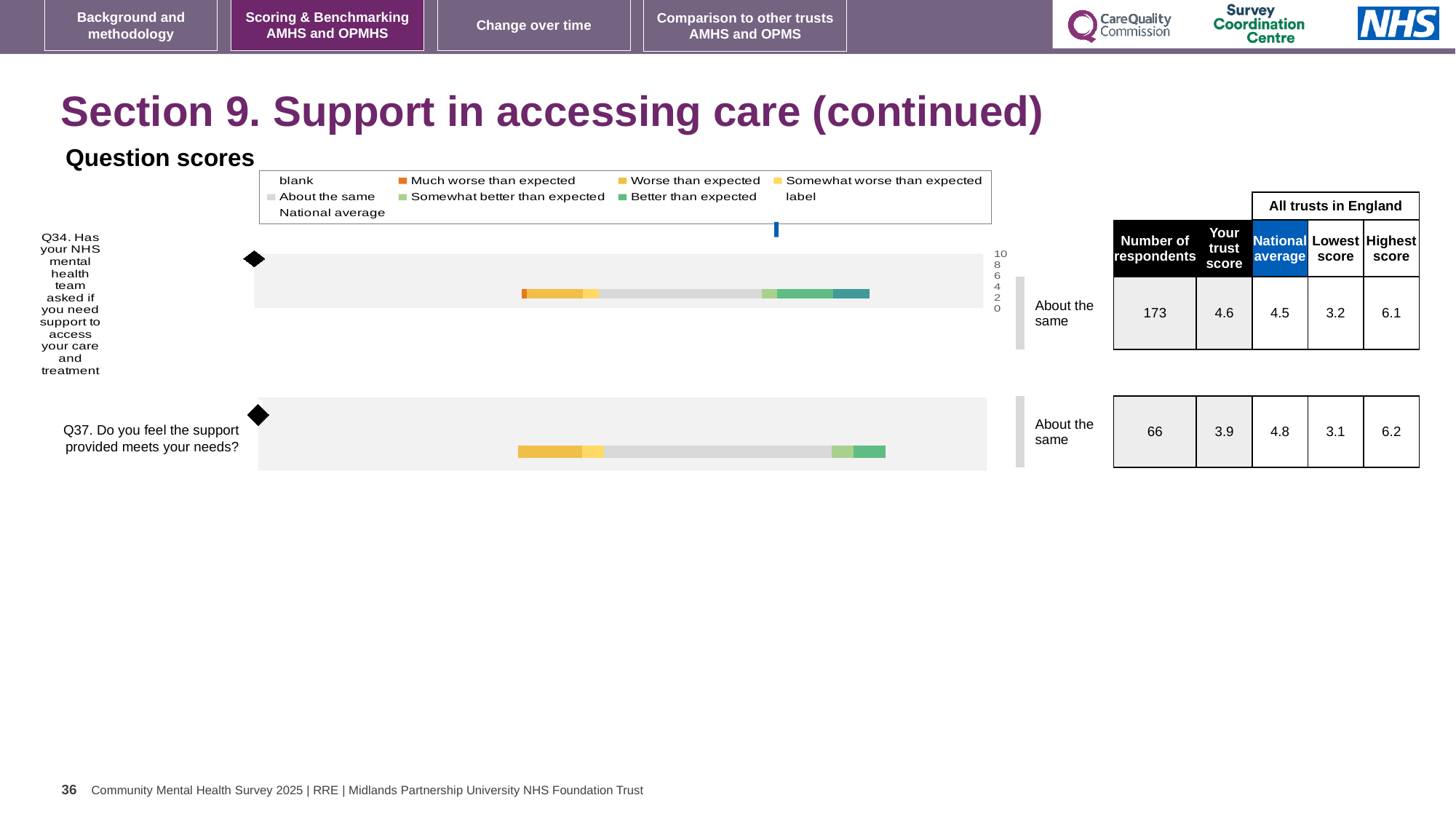
What kind of chart is used to show the benchmark results for Q34 and Q37? bar chart How many respondents answered Q34? 173 Which legend entry is shown in orange? Much worse than expected How many survey questions are plotted on the slide? 2 What benchmark category is printed next to the Q37 chart? About the same According to the table beside the Q34 chart, what is the trust score for Q34? 4.6 For Q37, what is the difference between the national average and the trust score? 0.9 According to the table beside the Q37 chart, what is the trust score for Q37? 3.9 What benchmark category is printed next to the Q34 chart? About the same What is the highest score among all trusts in England for Q37? 6.2 Which question has the higher trust score, Q34 or Q37? Q34 Which legend entry is shown in light grey? About the same